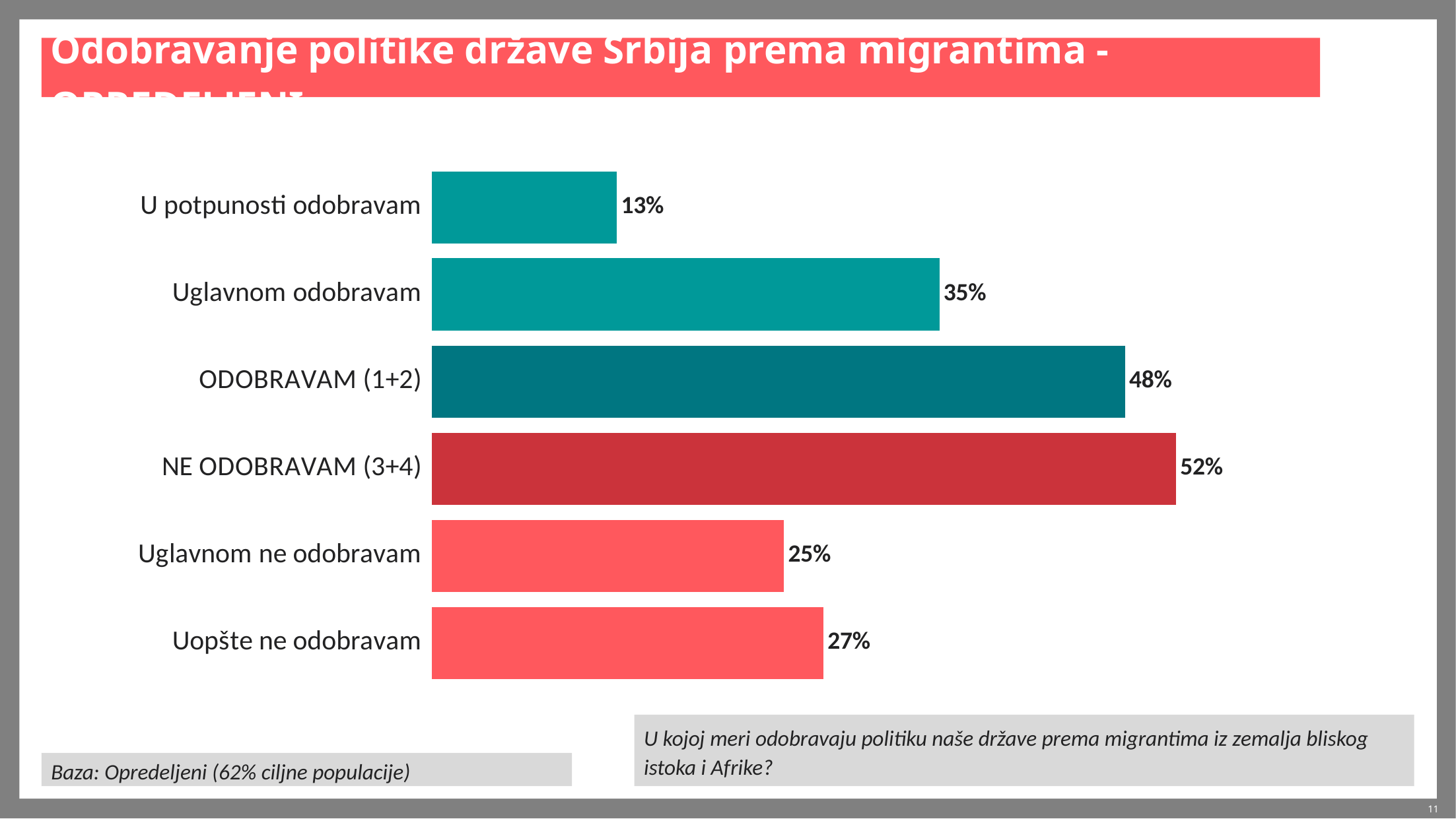
What is the value for "NE ODOBRAVAM (3+4)"? 52% What is the value for "U potpunosti odobravam"? 13% Which category has the highest value? NE ODOBRAVAM (3+4) What is the difference between "NE ODOBRAVAM (3+4)" and "ODOBRAVAM (1+2)"? 4% Which is larger, "Uglavnom ne odobravam" or "Uopšte ne odobravam"? Uopšte ne odobravam What is the value for "Uopšte ne odobravam"? 27% What is the difference between "Uglavnom odobravam" and "U potpunosti odobravam"? 22% Which category has the lowest value? U potpunosti odobravam How many categories are shown in the chart? 6 What is the value for "Uglavnom odobravam"? 35% What kind of chart is shown on the slide? Bar chart What is the value for "ODOBRAVAM (1+2)"? 48%